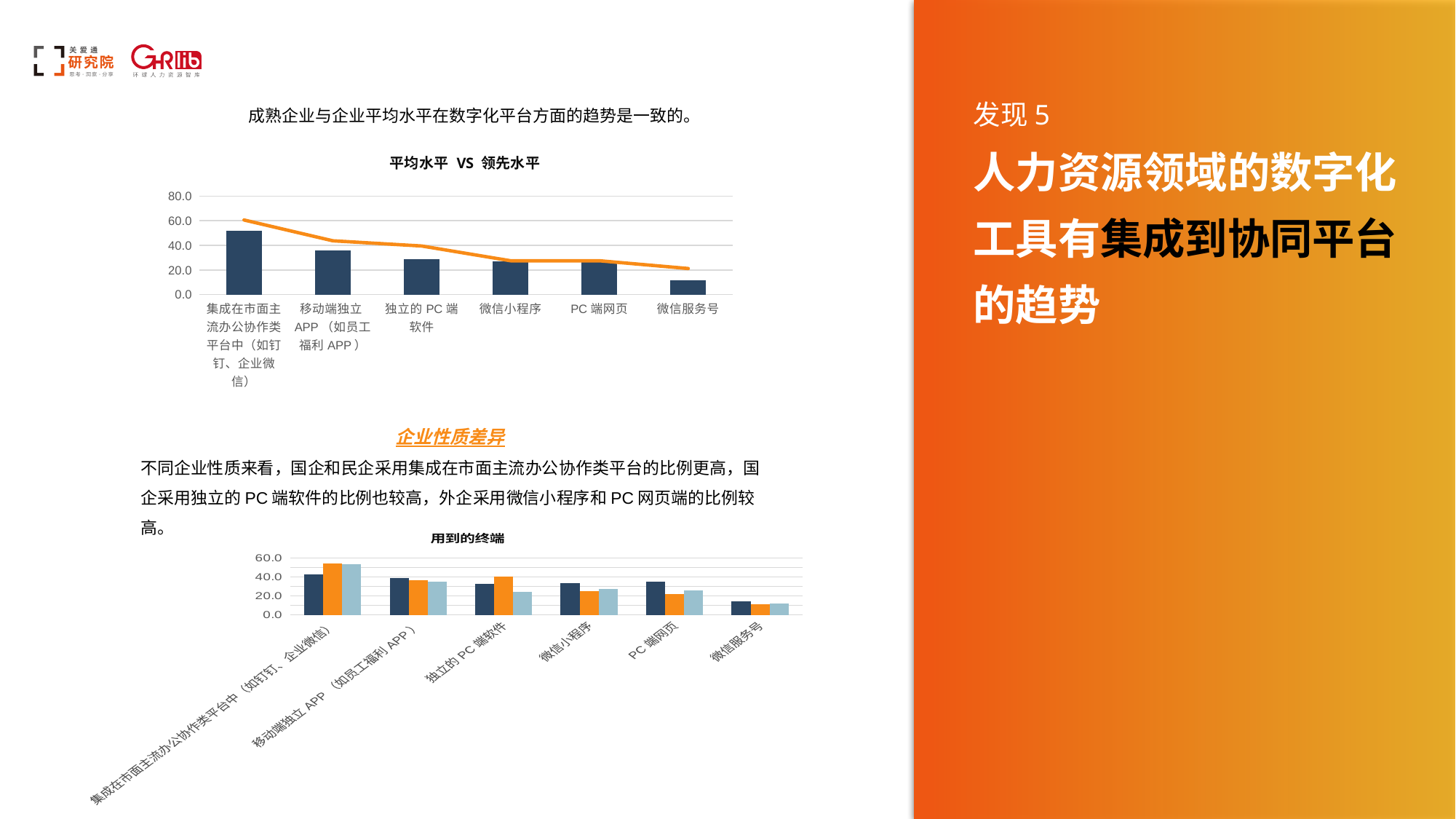
In the top chart (平均水平 VS 领先水平), do the bar values rise or fall moving from left to right along the x axis? fall In the top chart (平均水平 VS 领先水平), is the bar value for 集成在市面主流办公协作类平台中 greater or less than 40? greater In the top chart (平均水平 VS 领先水平), how many categories are shown on the x axis? 6 In the top chart (平均水平 VS 领先水平), which category has the shortest bar? 微信服务号 In the bottom chart (用到的终端), how many bars are plotted for each category? 3 In the bottom chart (用到的终端), how many categories are shown on the x axis? 6 In the bottom chart (用到的终端), is the orange bar for 集成在市面主流办公协作类平台中 greater or less than 40? greater In the top chart (平均水平 VS 领先水平), which has the larger bar value: 移动端独立 APP or PC 端网页? 移动端独立 APP In the top chart (平均水平 VS 领先水平), which category has the tallest bar? 集成在市面主流办公协作类平台中（如钉钉、企业微信） What kind of chart is the top chart titled 平均水平 VS 领先水平? Bar chart with a line overlay What is the title of the bottom chart? 用到的终端 In the top chart (平均水平 VS 领先水平), is the bar value for 微信服务号 greater or less than 20? less